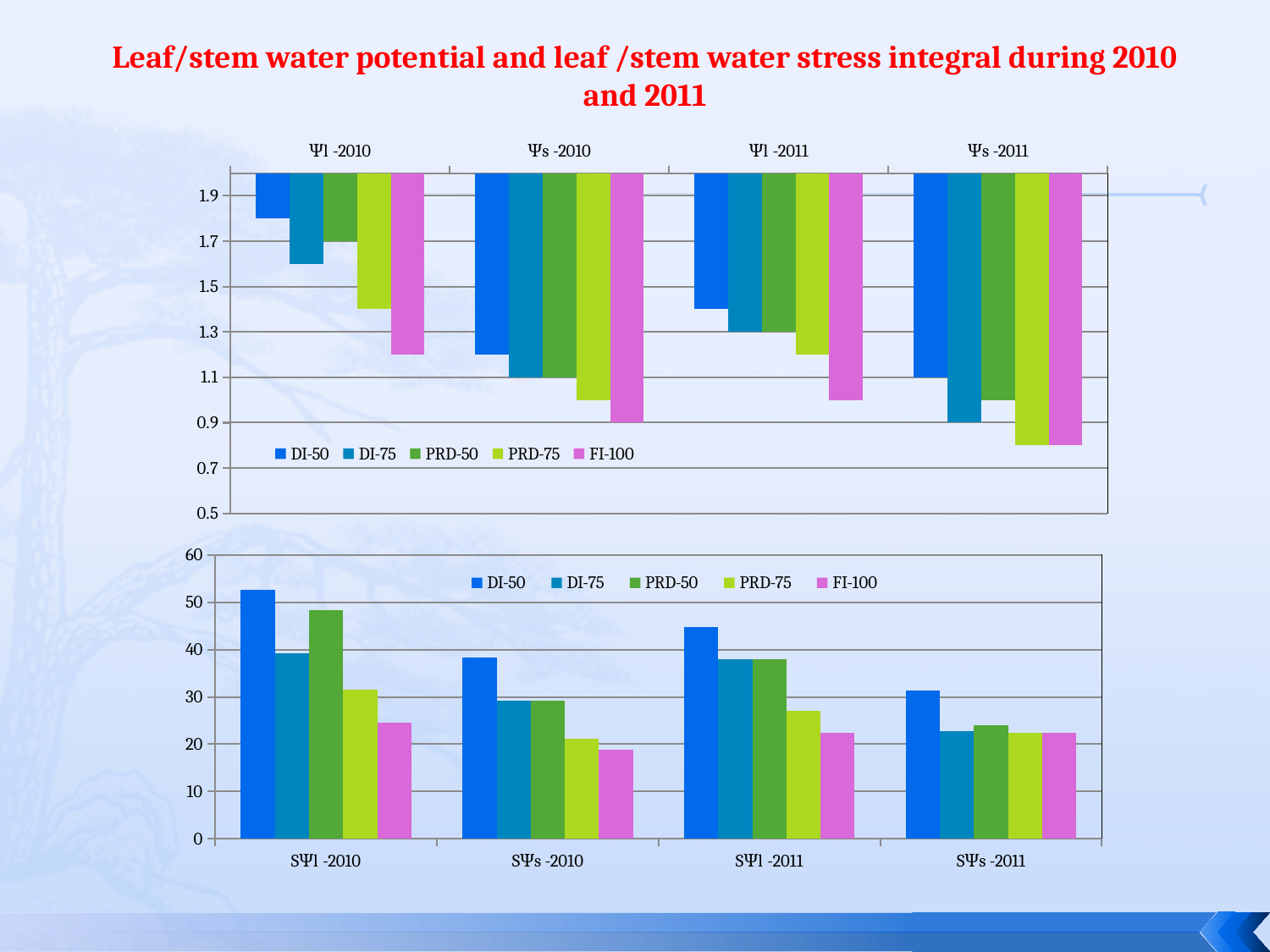
In the bottom chart, which series has the lowest value for SΨs -2010? FI-100 How many categories are shown on the x axis of the bottom chart? 4 What type of chart is the top chart on the slide? bar chart In the bottom chart, is the value of DI-50 for SΨs -2011 greater or less than 30? greater In the top chart, which series has the longest bar for Ψl -2010? FI-100 In the top chart, which is larger for Ψl -2011: the bar for DI-50 or the bar for FI-100? FI-100 In the bottom chart, is the value of FI-100 for SΨs -2010 greater or less than 20? less In the bottom chart, which is larger for SΨl -2011: DI-50 or PRD-75? DI-50 In the bottom chart, which series has the highest value for SΨl -2010? DI-50 In the bottom chart, is the value of DI-50 for SΨl -2010 greater or less than 50? greater How many series does the legend of the bottom chart list? 5 What colour are the FI-100 bars in both charts? pink